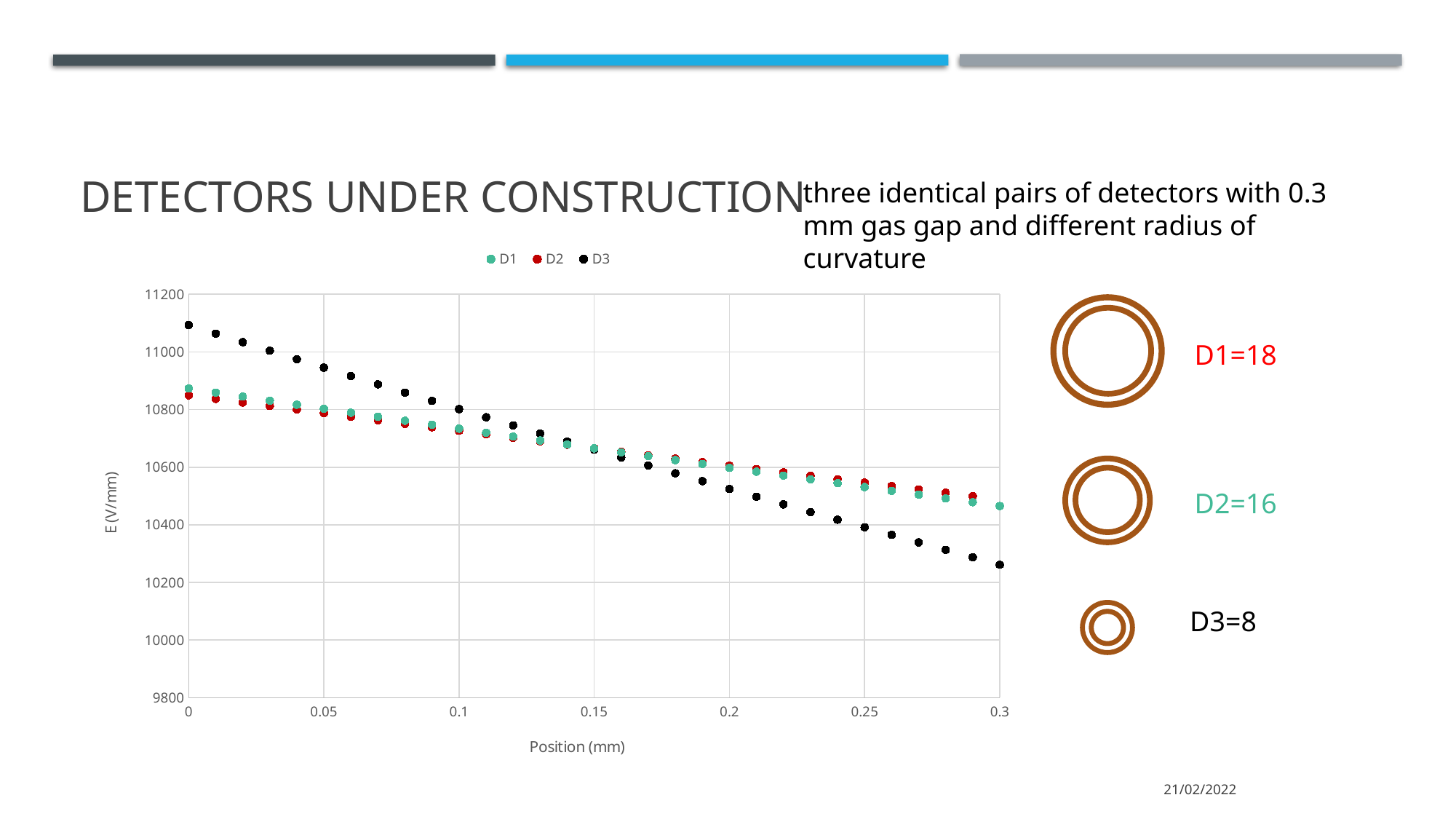
Is the value for D2 at position 0.3 greater or less than 10400? greater Is the value for D3 at position 0.3 greater or less than 10400? less Do the values of the D3 series rise or fall as position increases along the x axis? fall Is the value for D3 at position 0.2 greater or less than 10600? less How many series does the legend list? 3 What is the label of the y axis? E (V/mm) Do the values of the D1 series rise or fall as position increases along the x axis? fall Which series has the highest value at position 0? D3 Which series has the lowest value at position 0.3? D3 What kind of chart is shown on the slide? scatter chart